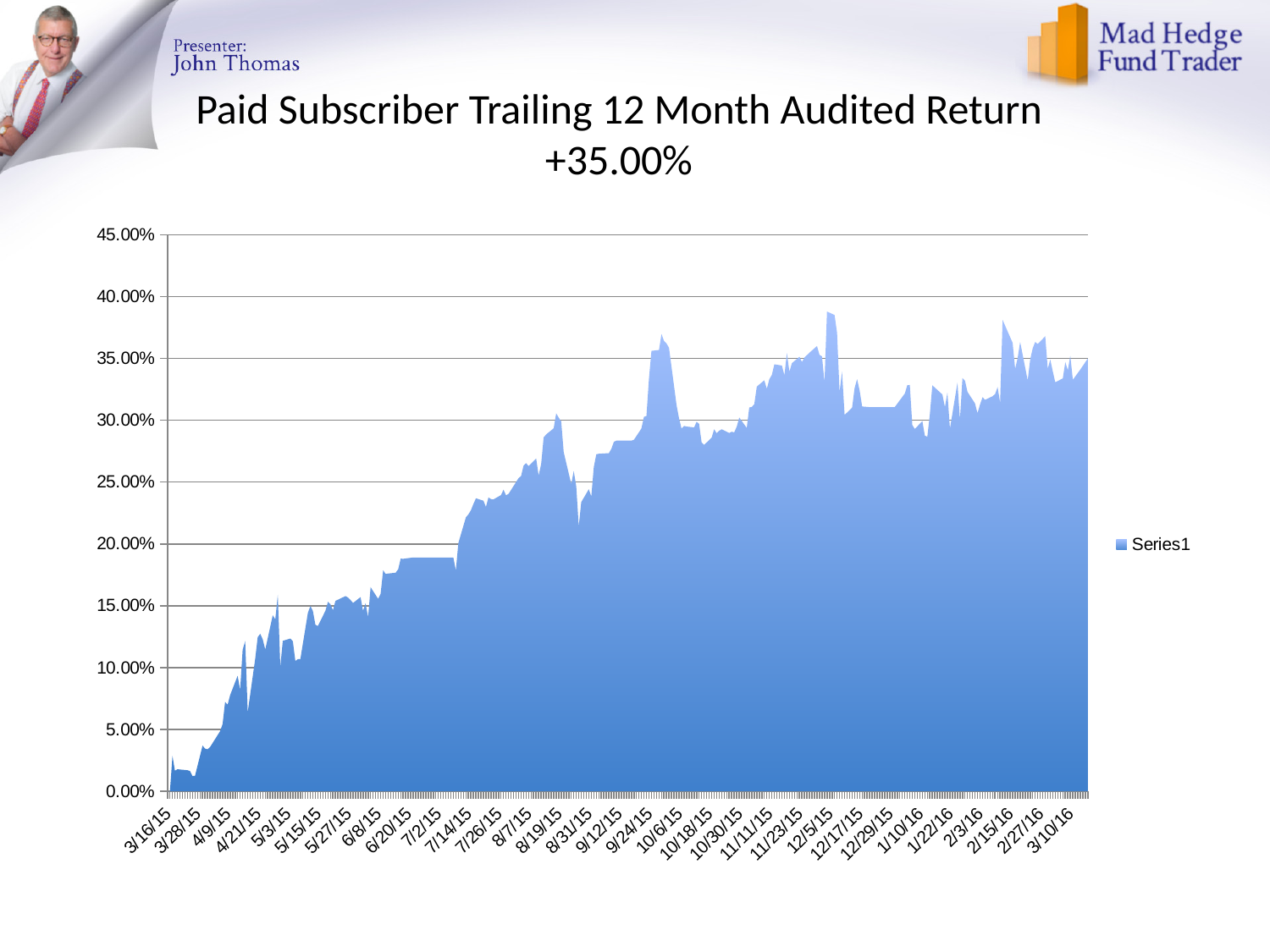
Is the value for 12/5/15 greater or less than 35.00%? greater Is the value for 8/7/15 greater or less than 25.00%? greater What return figure is stated in the chart title? +35.00% Is the value for 7/2/15 greater or less than 20.00%? less What kind of chart is shown on the slide? area chart Which has the larger value, 7/2/15 or 12/5/15? 12/5/15 What is the name of the series shown in the legend? Series1 Do the values generally rise or fall from 3/16/15 to 3/10/16? rise How many series does the legend list? 1 Which has the larger value, 3/16/15 or 3/10/16? 3/10/16